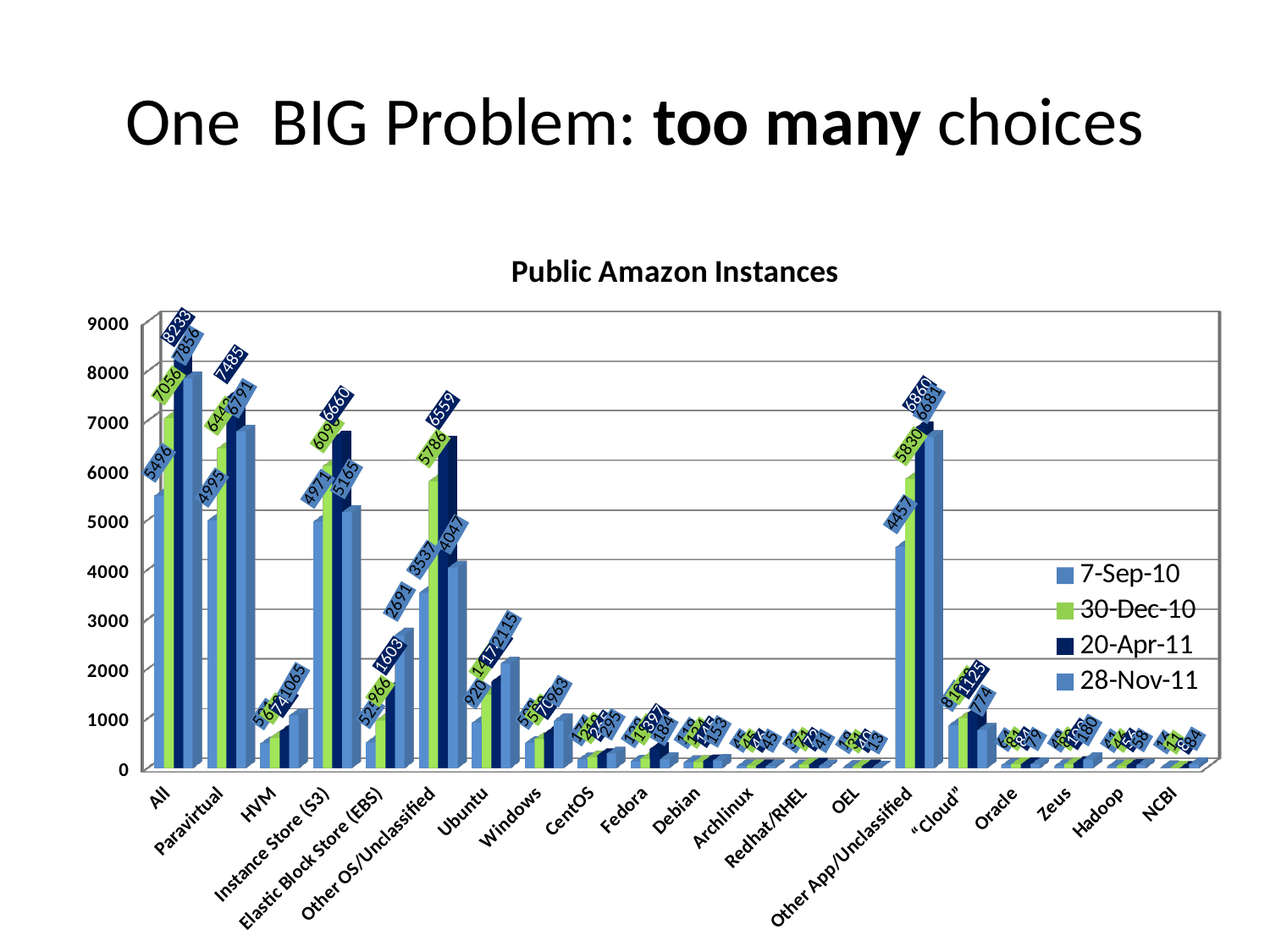
What is the value for Other App/Unclassified in the 20-Apr-11 series? 6860 What is the value for All in the 7-Sep-10 series? 5496 What is the difference between the 20-Apr-11 and 7-Sep-10 values for All? 2737 What kind of chart is shown on the slide? bar chart What is the value for Other OS/Unclassified in the 30-Dec-10 series? 5786 What is the title of the chart? Public Amazon Instances What is the value for Paravirtual in the 20-Apr-11 series? 7485 In the 20-Apr-11 series, which is larger: Paravirtual or Instance Store (S3)? Paravirtual What is the value for All in the 20-Apr-11 series? 8233 How many categories are shown on the x axis? 20 Which category has the highest value in the 20-Apr-11 series? All How many series does the legend list? 4